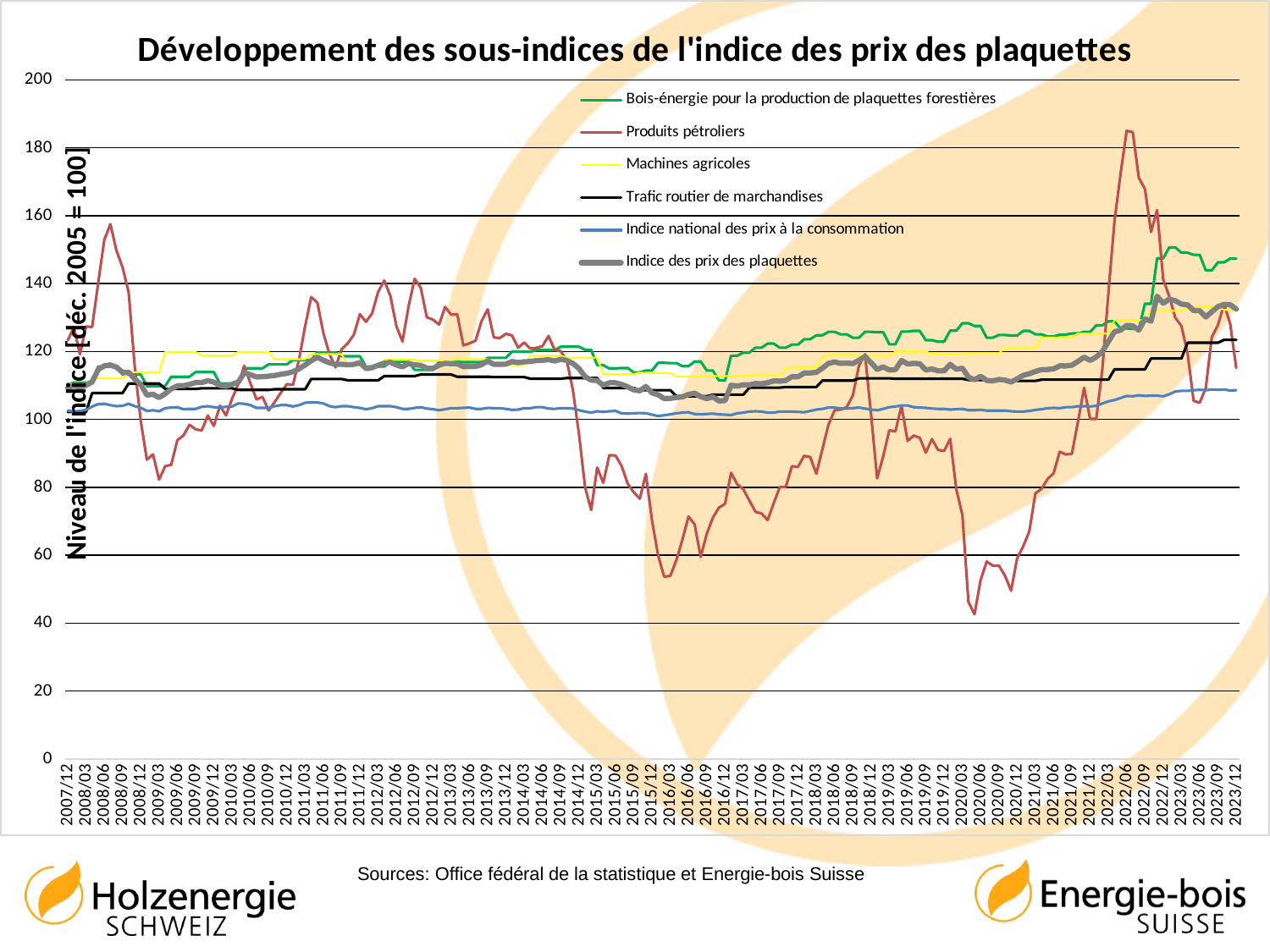
What is the label of the vertical axis? Niveau de l'indice [déc. 2005 = 100] Around 2020/06, which is higher: Indice des prix des plaquettes or Produits pétroliers? Indice des prix des plaquettes Which series reaches the lowest value anywhere on the chart? Produits pétroliers Is the lowest value of Produits pétroliers around 2020/06 greater or less than 60? less Does the Indice national des prix à la consommation rise or fall overall from 2007/12 to 2023/12? rise Which series reaches the highest value anywhere on the chart? Produits pétroliers How many series does the legend list? 6 What is the title of the chart? Développement des sous-indices de l'indice des prix des plaquettes What kind of chart is shown on the slide? line chart At 2023/12, which is higher: Bois-énergie pour la production de plaquettes forestières or Indice national des prix à la consommation? Bois-énergie pour la production de plaquettes forestières Is the value of Bois-énergie pour la production de plaquettes forestières at 2023/12 greater or less than 140? greater Is the peak value of Produits pétroliers around 2022/06 greater or less than 160? greater